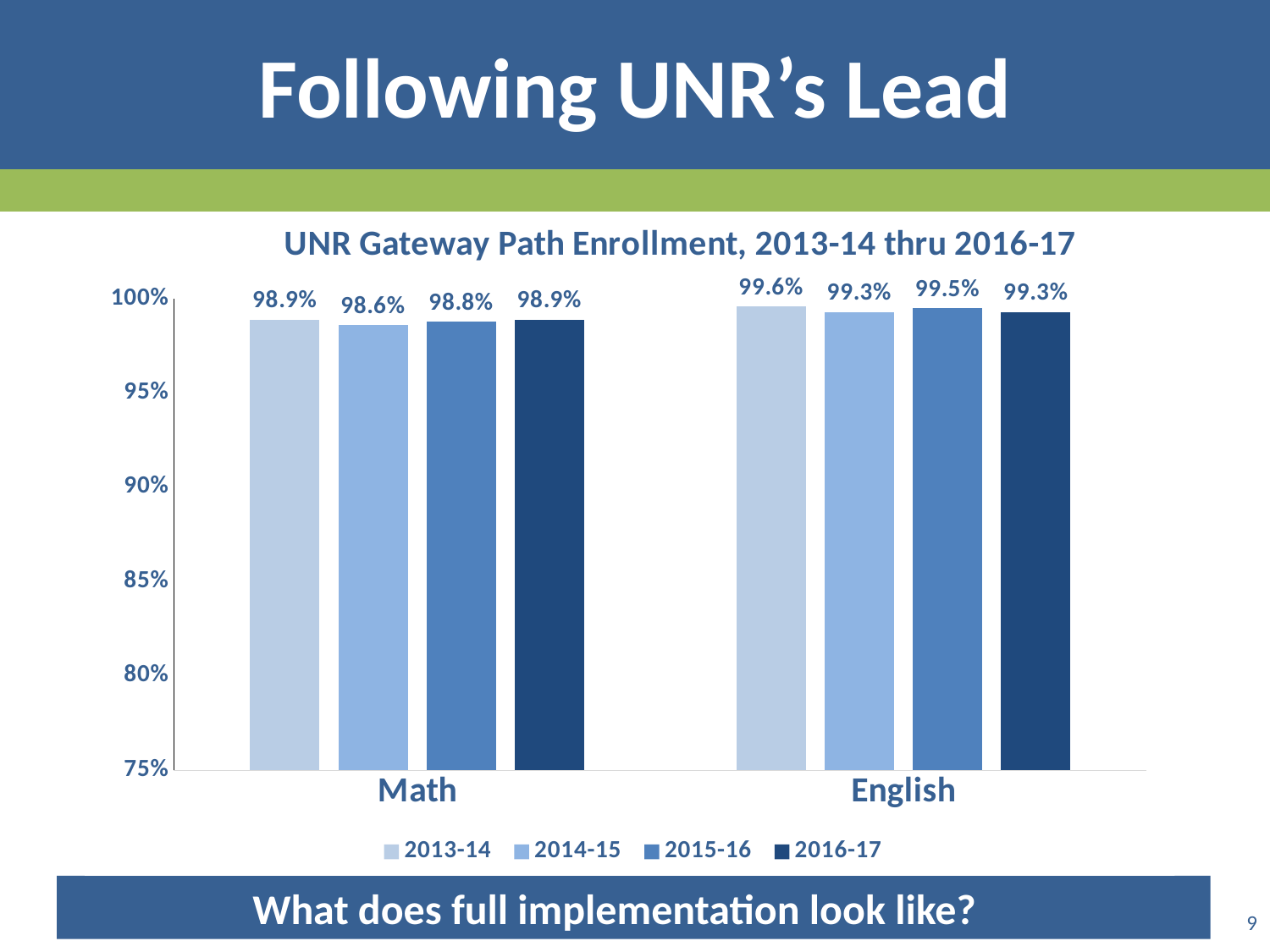
What is the title of the chart? UNR Gateway Path Enrollment, 2013-14 thru 2016-17 How many categories are shown on the x axis? 2 Which year has the lowest Math enrollment value? 2014-15 What is the Math enrollment value for 2013-14? 98.9% What is the difference between the English and Math values for 2013-14? 0.7% How many series does the legend list? 4 Which is larger, the Math value for 2016-17 or the English value for 2016-17? English Which year has the highest English enrollment value? 2013-14 What is the Math enrollment value for 2015-16? 98.8% What kind of chart is shown on the slide? Bar chart What is the English enrollment value for 2014-15? 99.3% What is the English enrollment value for 2016-17? 99.3%